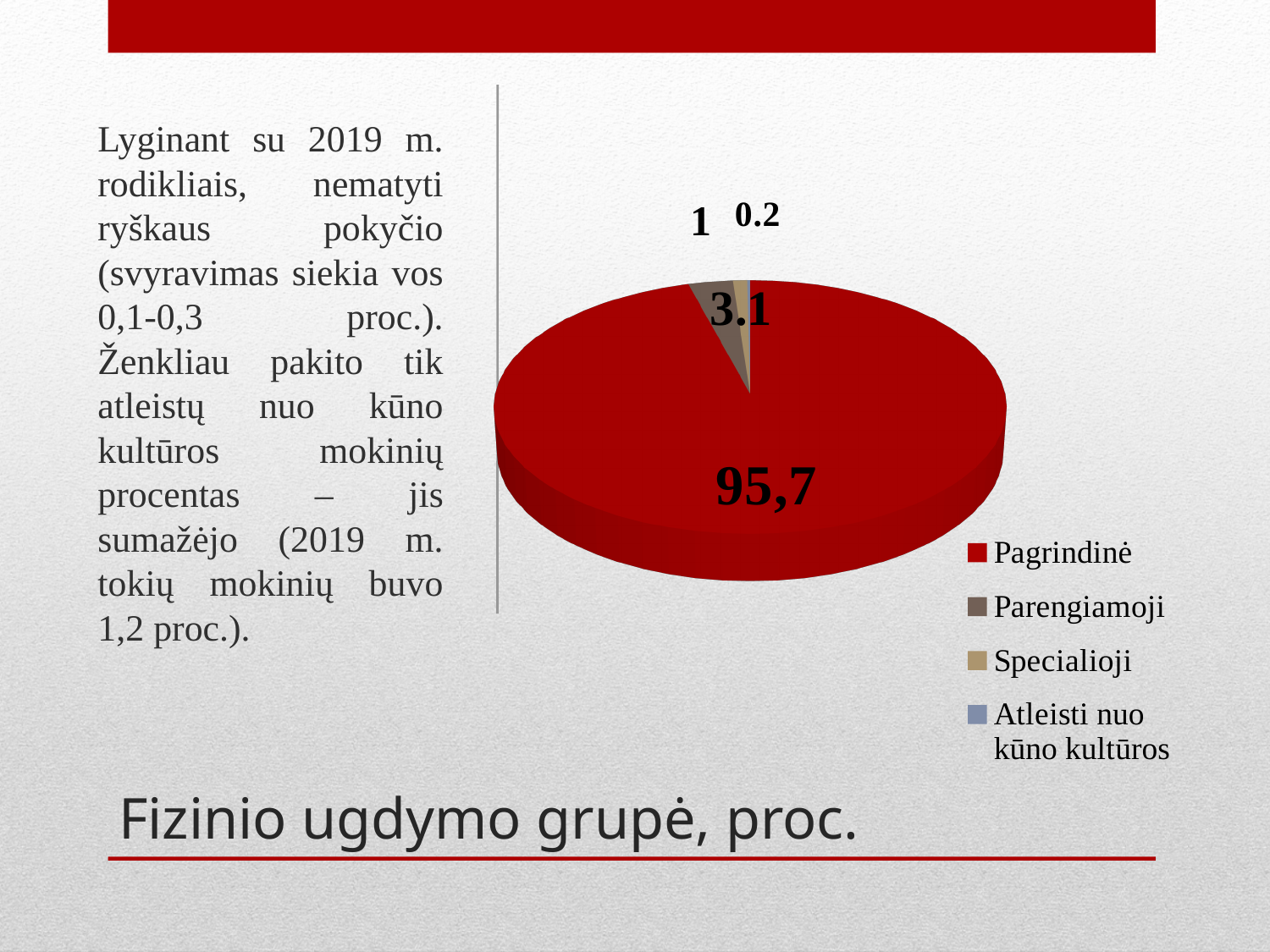
How many categories does the legend of the pie chart list? 4 What is the value for Parengiamoji in the pie chart? 3.1 Which category has the smallest slice of the pie chart? Atleisti nuo kūno kultūros What is the difference between the values for Specialioji and Atleisti nuo kūno kultūros? 0.8 Which category has the largest slice of the pie chart? Pagrindinė What is the title shown below the pie chart? Fizinio ugdymo grupė, proc. What is the value for Specialioji in the pie chart? 1 Which is larger, the value for Parengiamoji or the value for Specialioji? Parengiamoji What is the value for Atleisti nuo kūno kultūros in the pie chart? 0.2 What kind of chart is shown on the slide? pie chart What is the value for Pagrindinė in the pie chart? 95,7 What is the difference between the values for Parengiamoji and Specialioji? 2.1